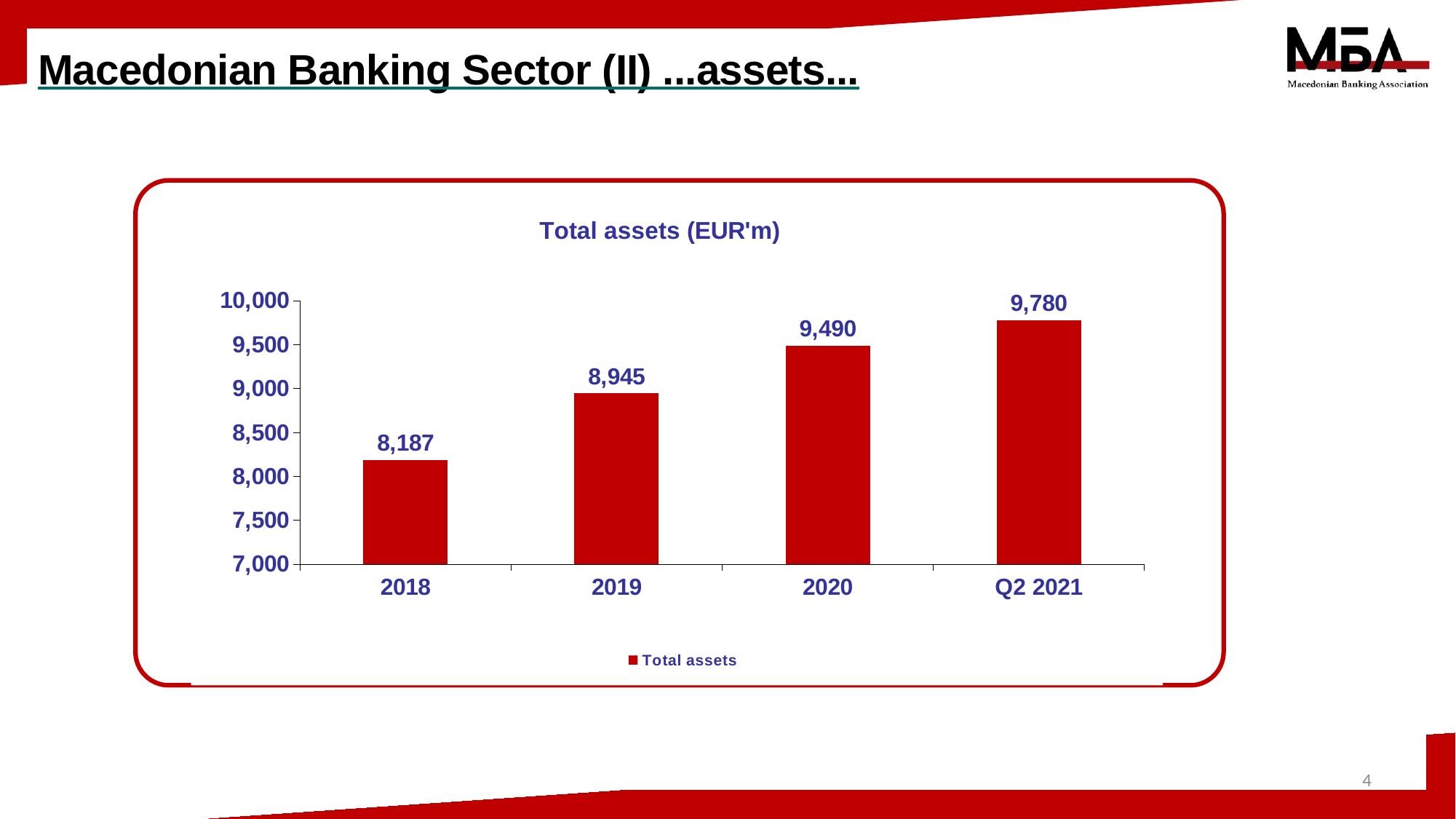
What kind of chart is shown on the slide? Bar chart What is the value of total assets for 2018? 8,187 Which is larger, total assets in 2019 or in 2020? 2020 What is the value of total assets for Q2 2021? 9,780 Which period has the highest total assets? Q2 2021 Do total assets rise or fall from 2018 to Q2 2021? Rise How many periods are shown on the x axis? 4 What is the value of total assets for 2020? 9,490 What is the difference in total assets between 2020 and 2019? 545 What is the value of total assets for 2019? 8,945 What is the difference in total assets between Q2 2021 and 2018? 1,593 Which period has the lowest total assets? 2018